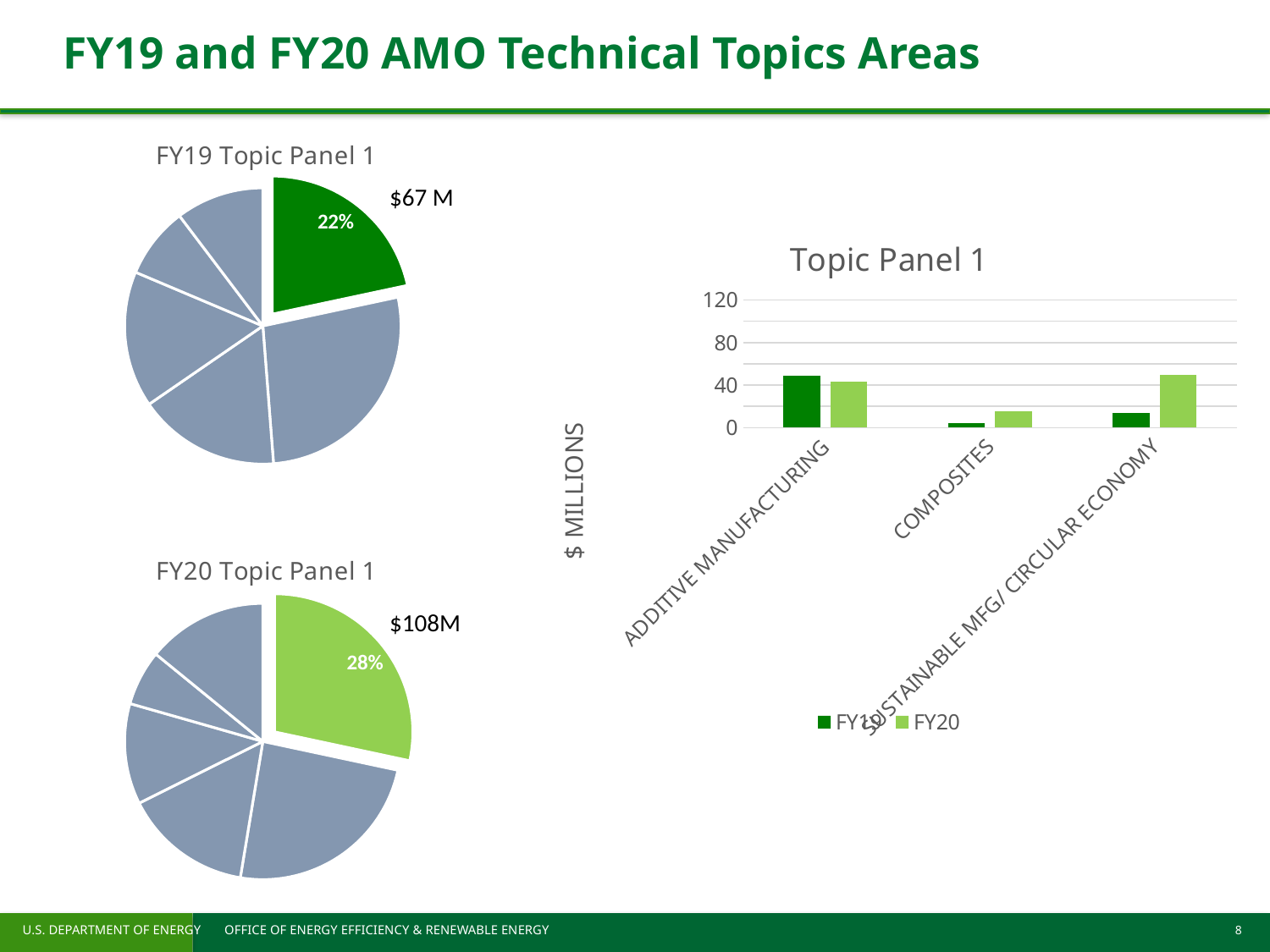
In the Topic Panel 1 bar chart, is the FY19 value for Additive Manufacturing greater or less than 40? greater In the FY19 Topic Panel 1 pie chart, what dollar amount is labelled next to the highlighted slice? $67 M In the Topic Panel 1 bar chart, which category has the lowest FY19 value? Composites How many series does the legend of the Topic Panel 1 bar chart list? 2 What kind of chart is the Topic Panel 1 chart on the right of the slide? Bar chart Which is larger: the highlighted share in the FY19 Topic Panel 1 pie or the highlighted share in the FY20 Topic Panel 1 pie? FY20 (28%) In the FY20 Topic Panel 1 pie chart, what dollar amount is labelled next to the highlighted slice? $108M In the FY20 Topic Panel 1 pie chart, what percentage does the highlighted green slice represent? 28% In the FY19 Topic Panel 1 pie chart, what percentage does the highlighted green slice represent? 22% In the Topic Panel 1 bar chart, is the FY20 value for Composites greater or less than 40? less How many categories are shown on the x axis of the Topic Panel 1 bar chart? 3 In the Topic Panel 1 bar chart, for Sustainable Mfg/Circular Economy, which is larger: the FY19 bar or the FY20 bar? FY20